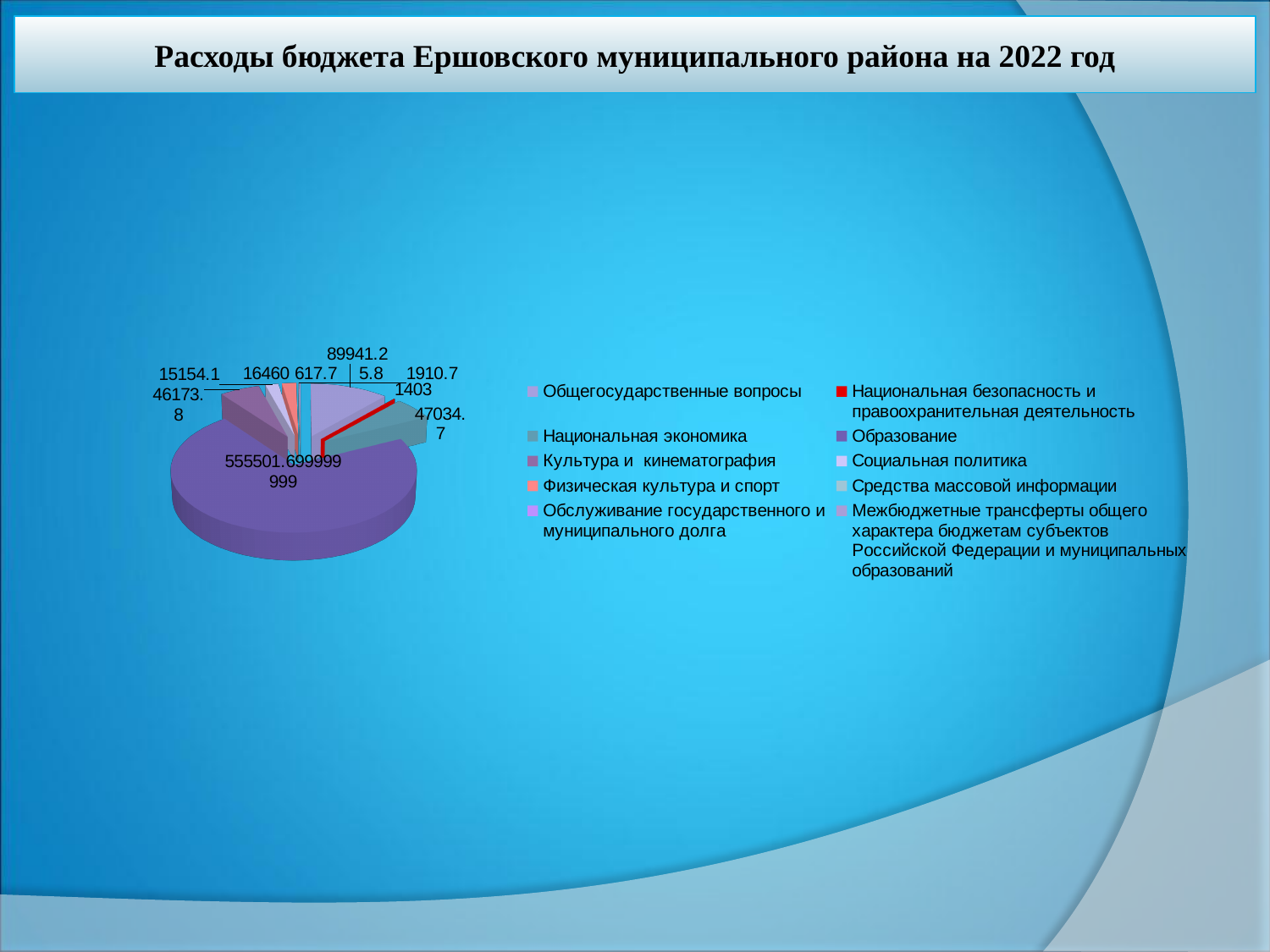
What type of chart is shown on the slide? Pie chart What is the smallest data label value shown on the pie chart? 5.8 How many categories does the legend of the pie chart list? 10 Which legend entry is marked with a red colour? Национальная безопасность и правоохранительная деятельность What value is shown for the Общегосударственные вопросы slice? 89941.2 Which is larger: Общегосударственные вопросы or Национальная экономика? Общегосударственные вопросы Which category has the largest slice in the pie chart? Образование What is the title of the slide containing the chart? Расходы бюджета Ершовского муниципального района на 2022 год What is the difference between the values for Общегосударственные вопросы and Национальная экономика? 42906.5 How many data labels are shown on the pie chart? 10 What value is shown for the Образование slice? 555501.699999999 What value is shown for the Национальная экономика slice? 47034.7